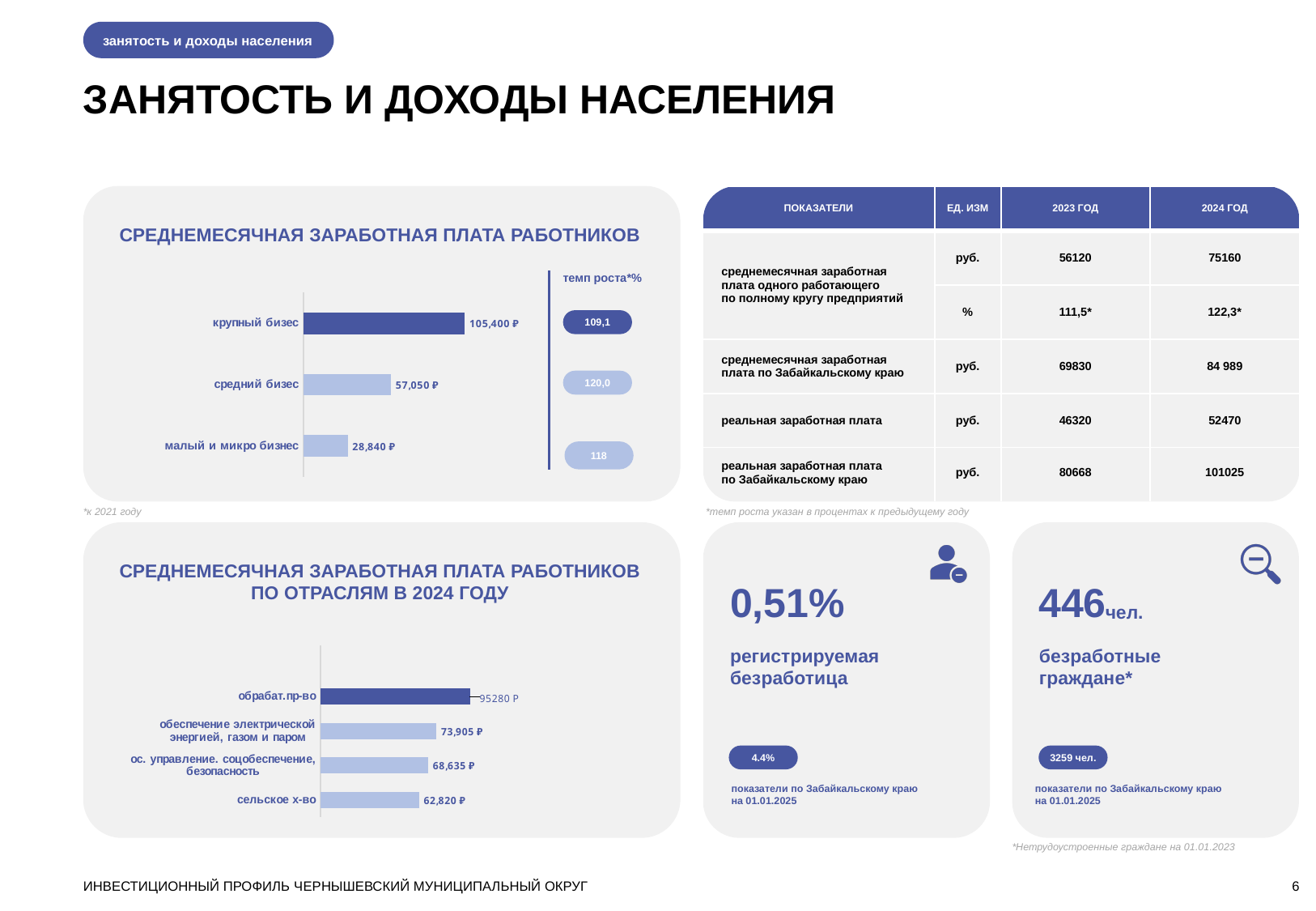
In the chart 'СРЕДНЕМЕСЯЧНАЯ ЗАРАБОТНАЯ ПЛАТА РАБОТНИКОВ', which category has the lowest value? малый и микро бизнес In the chart 'СРЕДНЕМЕСЯЧНАЯ ЗАРАБОТНАЯ ПЛАТА РАБОТНИКОВ ПО ОТРАСЛЯМ В 2024 ГОДУ', what is the value for 'обеспечение электрической энергией, газом и паром'? 73,905 ₽ In the chart 'СРЕДНЕМЕСЯЧНАЯ ЗАРАБОТНАЯ ПЛАТА РАБОТНИКОВ ПО ОТРАСЛЯМ В 2024 ГОДУ', which is larger: 'ос. управление. соцобеспечение, безопасность' or 'сельское х-во'? ос. управление. соцобеспечение, безопасность In the chart 'СРЕДНЕМЕСЯЧНАЯ ЗАРАБОТНАЯ ПЛАТА РАБОТНИКОВ', what is the value for 'крупный бизнес'? 105,400 ₽ In the chart 'СРЕДНЕМЕСЯЧНАЯ ЗАРАБОТНАЯ ПЛАТА РАБОТНИКОВ', how many categories are shown? 3 In the chart 'СРЕДНЕМЕСЯЧНАЯ ЗАРАБОТНАЯ ПЛАТА РАБОТНИКОВ', what is the difference between 'крупный бизнес' and 'средний бизнес'? 48,350 ₽ What kind of chart is 'СРЕДНЕМЕСЯЧНАЯ ЗАРАБОТНАЯ ПЛАТА РАБОТНИКОВ ПО ОТРАСЛЯМ В 2024 ГОДУ'? bar chart In the chart 'СРЕДНЕМЕСЯЧНАЯ ЗАРАБОТНАЯ ПЛАТА РАБОТНИКОВ ПО ОТРАСЛЯМ В 2024 ГОДУ', what is the value for 'сельское х-во'? 62,820 ₽ In the chart 'СРЕДНЕМЕСЯЧНАЯ ЗАРАБОТНАЯ ПЛАТА РАБОТНИКОВ', which category has the highest value? крупный бизнес In the chart 'СРЕДНЕМЕСЯЧНАЯ ЗАРАБОТНАЯ ПЛАТА РАБОТНИКОВ', what is the value for 'малый и микро бизнес'? 28,840 ₽ In the chart 'СРЕДНЕМЕСЯЧНАЯ ЗАРАБОТНАЯ ПЛАТА РАБОТНИКОВ', what is the 'темп роста' value shown for 'средний бизнес'? 120,0 In the chart 'СРЕДНЕМЕСЯЧНАЯ ЗАРАБОТНАЯ ПЛАТА РАБОТНИКОВ ПО ОТРАСЛЯМ В 2024 ГОДУ', which category has the highest value? обрабат.пр-во